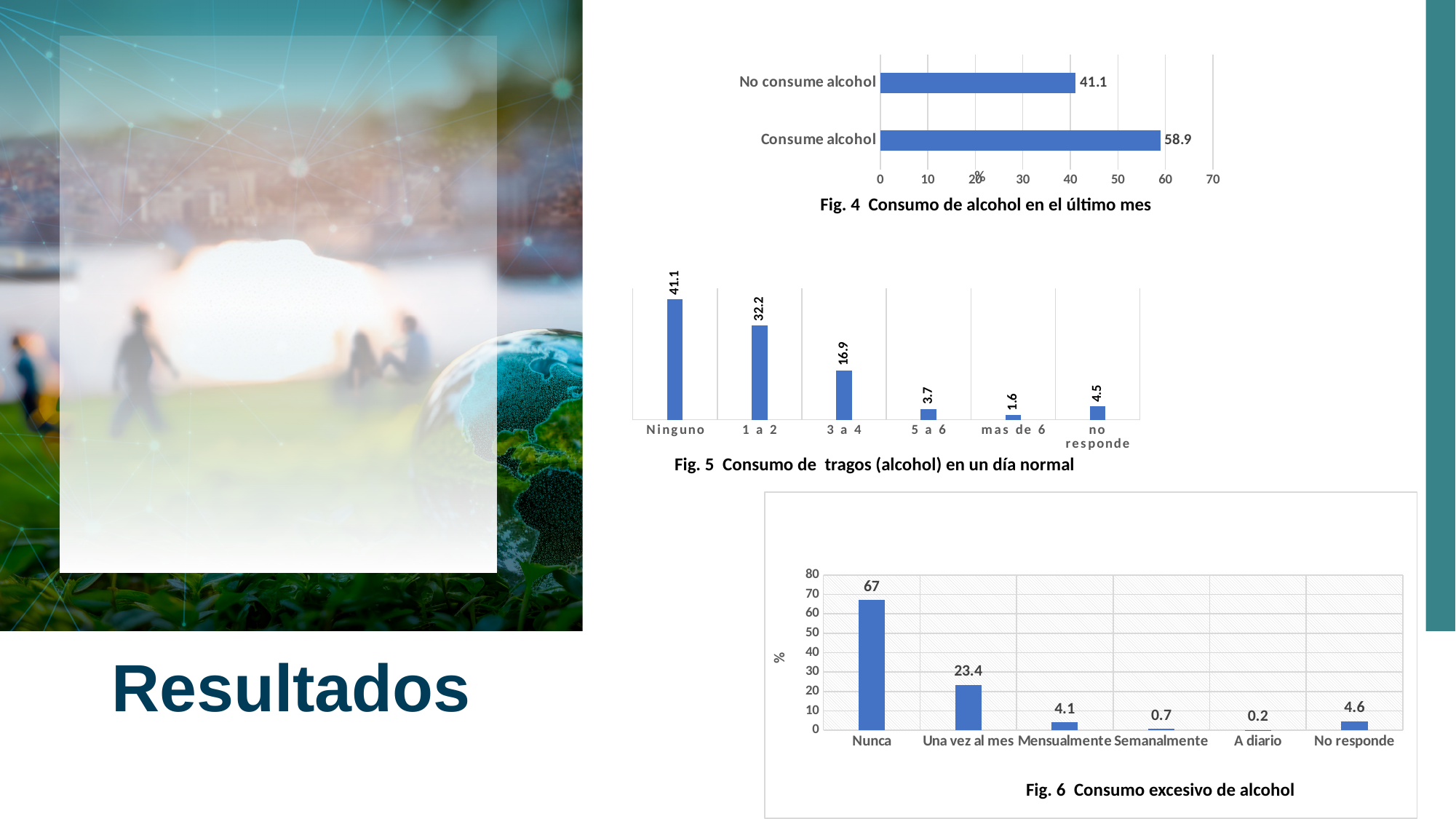
In Fig. 5 (Consumo de tragos (alcohol) en un día normal), which category has the highest value? Ninguno In Fig. 6 (Consumo excesivo de alcohol), what is the value for 'Una vez al mes'? 23.4 In Fig. 4 (Consumo de alcohol en el último mes), what is the difference between 'Consume alcohol' and 'No consume alcohol'? 17.8 In Fig. 6 (Consumo excesivo de alcohol), what is the difference between 'Nunca' and 'Una vez al mes'? 43.6 In Fig. 6 (Consumo excesivo de alcohol), which category has the lowest value? A diario What kind of chart is Fig. 4 (Consumo de alcohol en el último mes)? Bar chart In Fig. 5 (Consumo de tragos (alcohol) en un día normal), what is the value for '3 a 4'? 16.9 In Fig. 5 (Consumo de tragos (alcohol) en un día normal), which category has the lowest value? mas de 6 In Fig. 4 (Consumo de alcohol en el último mes), what is the value for 'Consume alcohol'? 58.9 How many categories are shown in Fig. 5 (Consumo de tragos (alcohol) en un día normal)? 6 In Fig. 5 (Consumo de tragos (alcohol) en un día normal), which is larger: '5 a 6' or 'no responde'? no responde In Fig. 6 (Consumo excesivo de alcohol), what is the label on the vertical axis? %